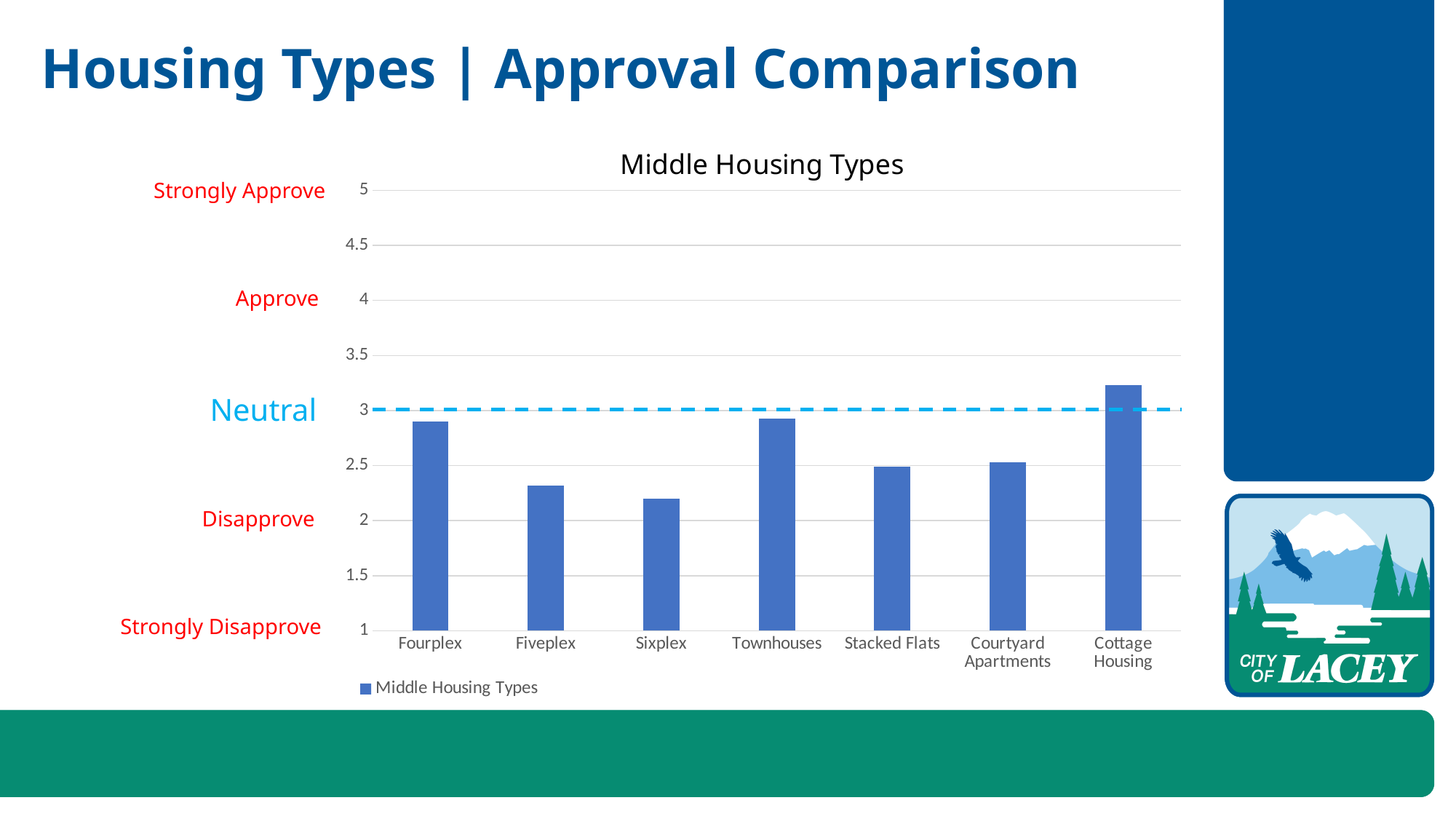
What kind of chart is shown on the slide? Bar chart Is the value for Cottage Housing greater or less than 3? greater Which is larger, the value for Fourplex or the value for Fiveplex? Fourplex How many series does the legend list? 1 Is the value for Fourplex greater or less than 3? less What is the title of the chart? Middle Housing Types Which housing type has the lowest value? Sixplex Is the value for Fiveplex greater or less than 2.5? less How many housing types are plotted on the chart? 7 Which is larger, the value for Townhouses or the value for Stacked Flats? Townhouses Which housing type has the highest value? Cottage Housing